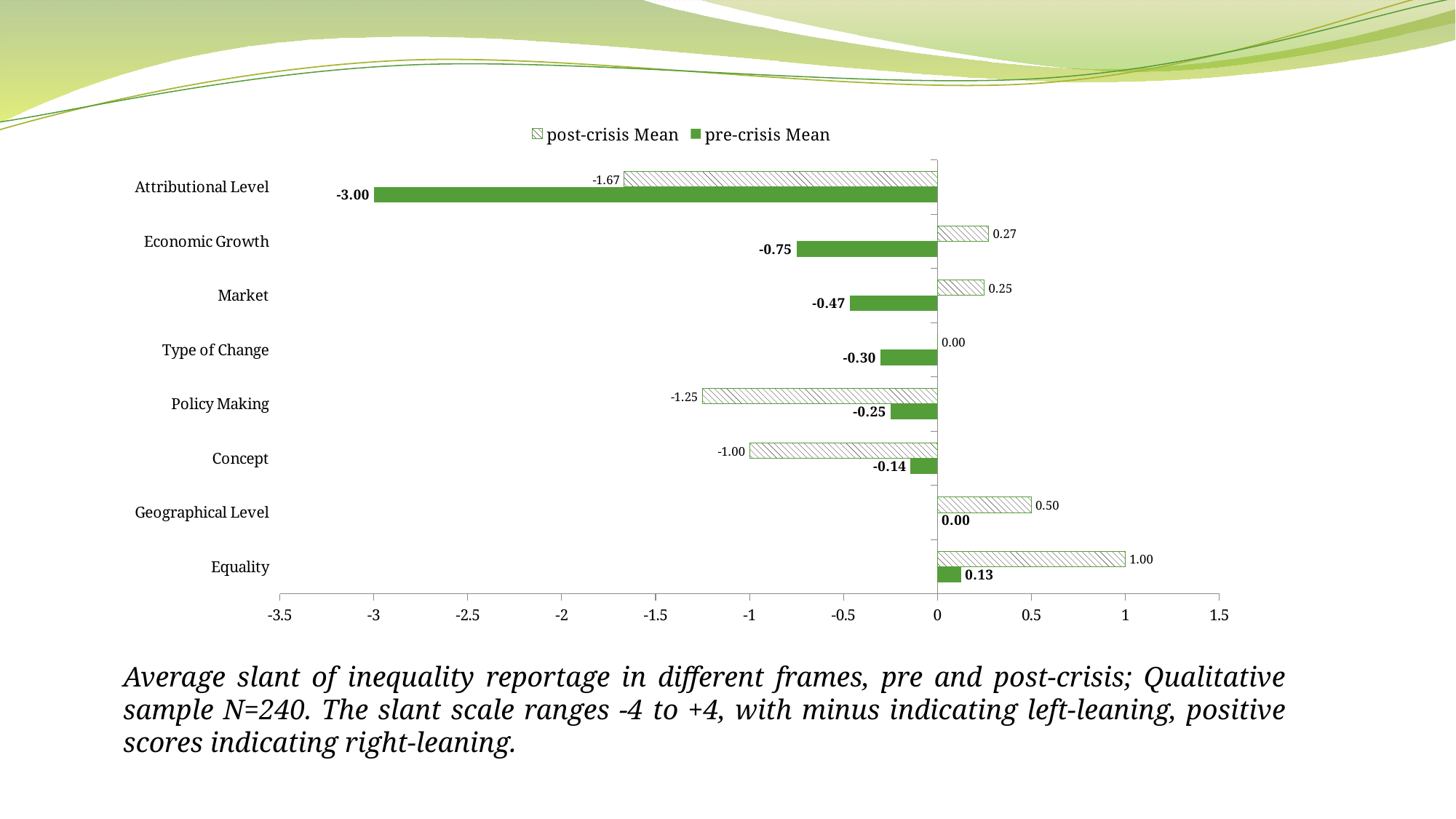
What is the post-crisis Mean for Equality? 1.00 What is the difference between the post-crisis Mean and the pre-crisis Mean for Attributional Level? 1.33 What is the post-crisis Mean for Policy Making? -1.25 What is the pre-crisis Mean for Market? -0.47 Which series is drawn with a hatched pattern in the legend? post-crisis Mean How many categories are shown on the chart? 8 Which category has the highest post-crisis Mean? Equality How many series does the legend list? 2 What is the pre-crisis Mean for Attributional Level? -3.00 Which is larger for Economic Growth, the pre-crisis Mean or the post-crisis Mean? post-crisis Mean Which category has the lowest pre-crisis Mean? Attributional Level What kind of chart is shown on the slide? bar chart